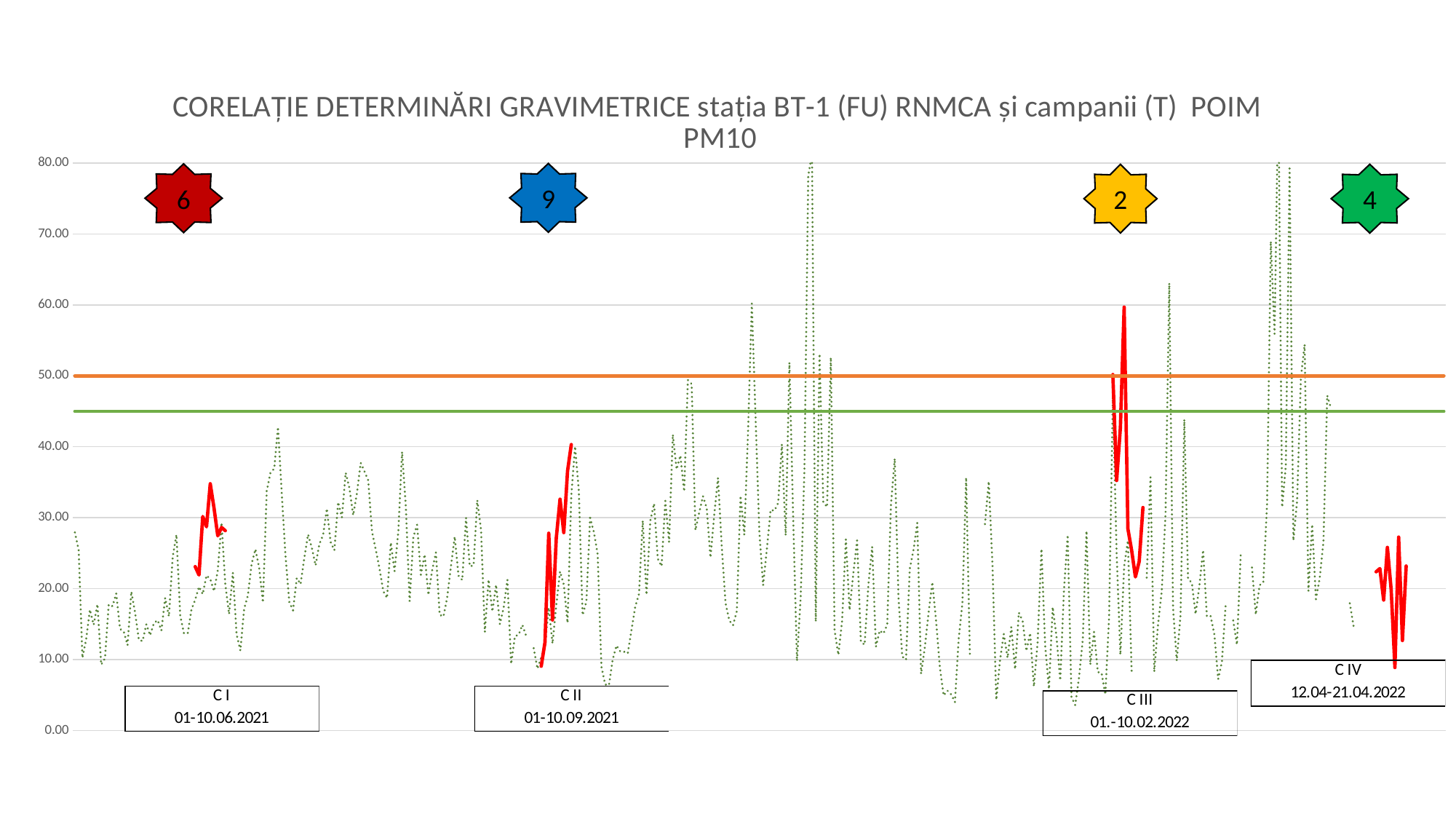
What kind of chart is shown on the slide? line chart Is the peak of the red line during campaign C I greater or less than 40.00? less Is the peak of the red line during campaign C III greater or less than 50.00? greater What is the highest value shown on the vertical axis? 80.00 Are the red line values during campaign C IV greater or less than 30.00? less Which campaign has the highest peak in the red line: C I, C II, C III or C IV? C III What date range is given for campaign C II? 01-10.09.2021 How many campaign periods (C I to C IV) are labelled on the chart? 4 What is the title of the chart? CORELAȚIE DETERMINĂRI GRAVIMETRICE stația BT-1 (FU) RNMCA și campanii (T) POIM PM10 At what value on the vertical axis does the orange horizontal line sit? 50.00